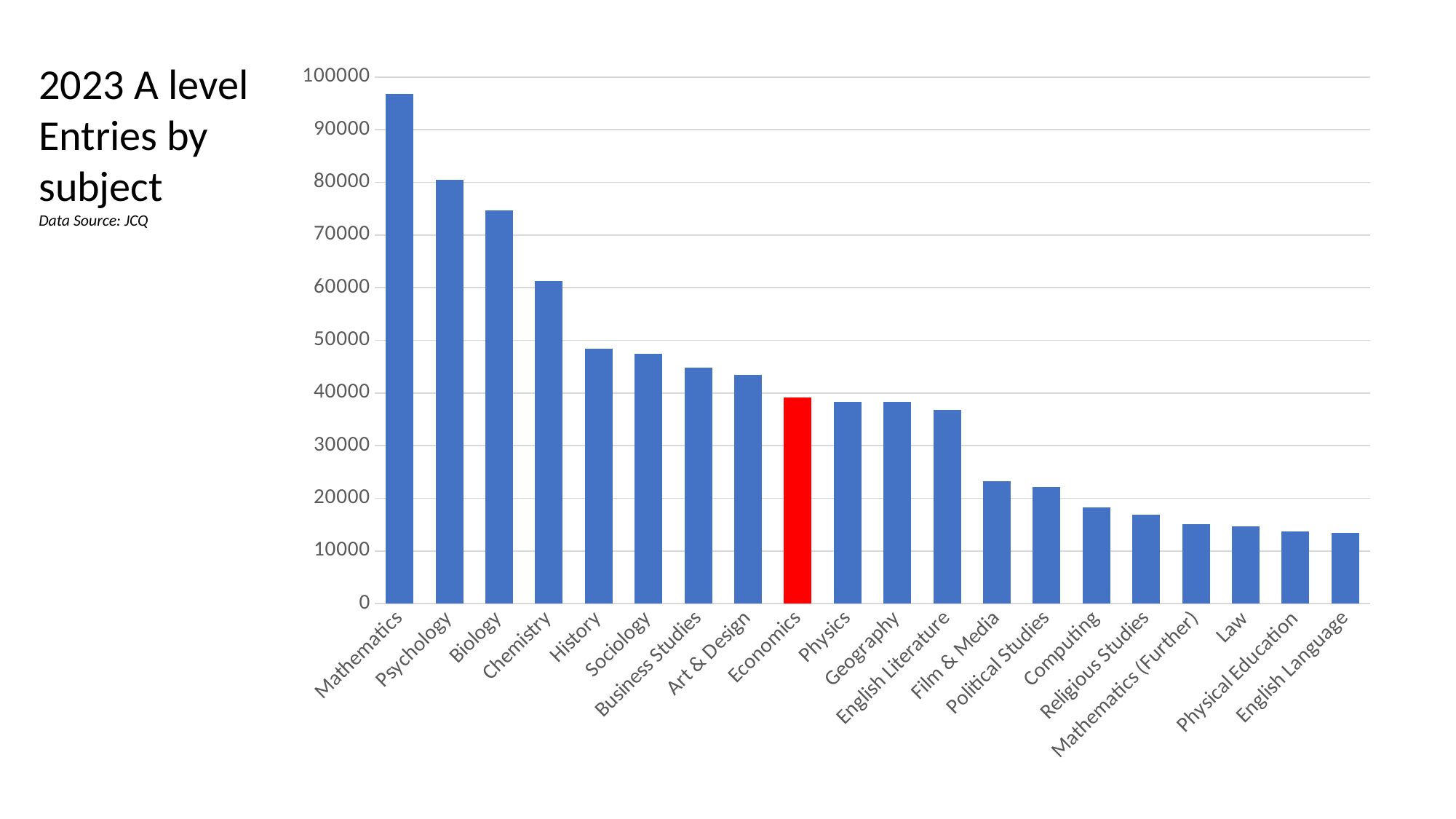
What kind of chart is shown on the slide? Bar chart Is the value for History greater or less than 50000? less Is the value for Biology greater or less than 70000? greater How many subjects are shown on the x axis? 20 Is the value for Mathematics greater or less than 90000? greater Which has more entries, Psychology or Biology? Psychology Which has more entries, Chemistry or History? Chemistry Which subject has the highest number of A level entries? Mathematics Do the values rise or fall moving from left to right along the x axis? Fall Which subject's bar is coloured red? Economics